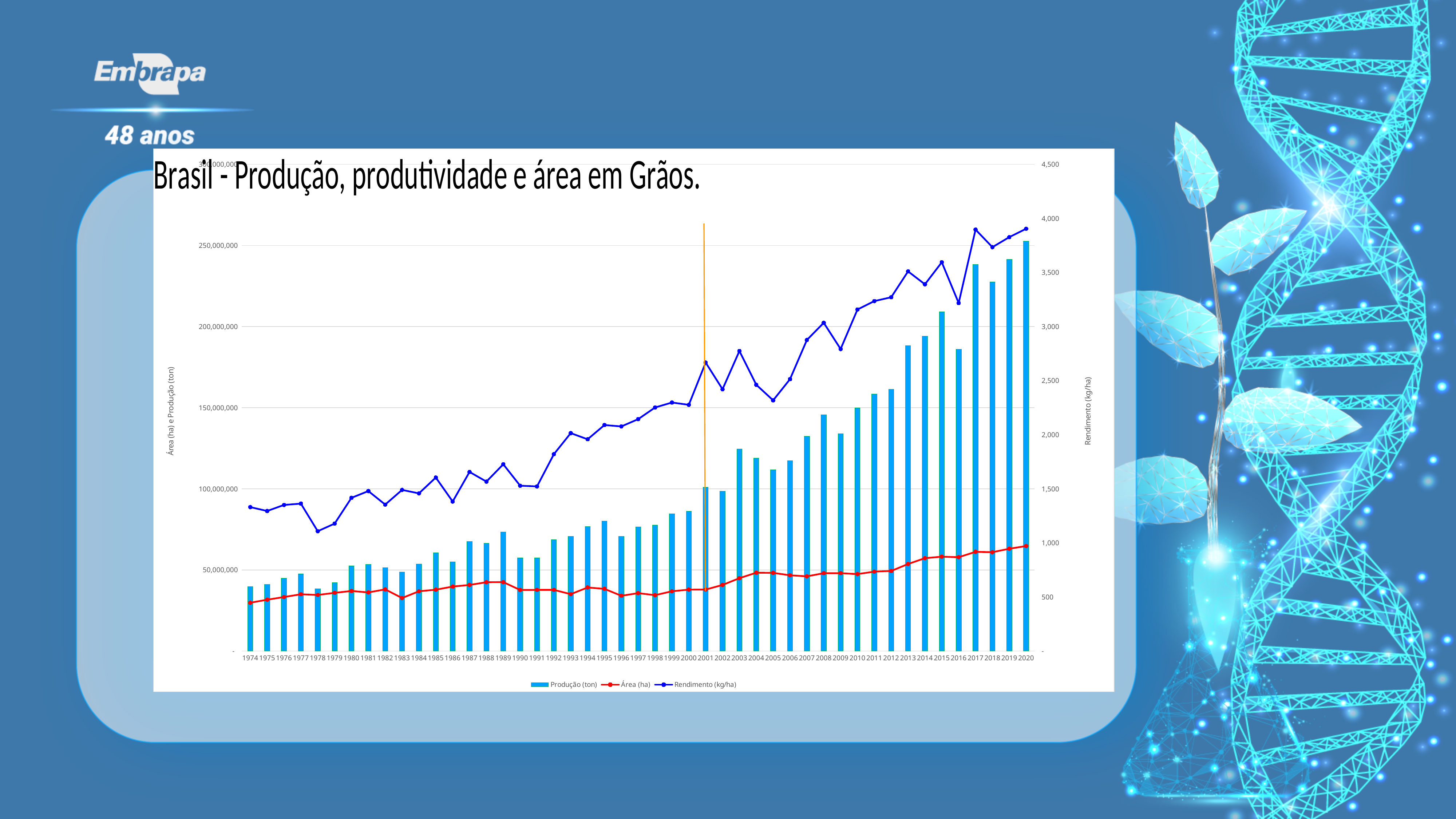
How many series does the legend list? 3 In which year is Rendimento (kg/ha) lowest? 1978 Is the Produção (ton) value for 2020 greater or less than 200,000,000? greater Does Produção (ton) generally rise or fall from 1974 to 2020? rise In which year is Produção (ton) highest? 2020 How many years are shown on the x axis? 47 Is the Rendimento (kg/ha) value for 2020 greater or less than 3,500? greater Is the Produção (ton) value for 1974 greater or less than 50,000,000? less What kind of chart is shown on the slide? A combined bar and line chart What is the title of the chart? Brasil - Produção, produtividade e área em Grãos. Which series is drawn as a red line? Área (ha) Which year has the higher Rendimento (kg/ha), 2001 or 2002? 2001